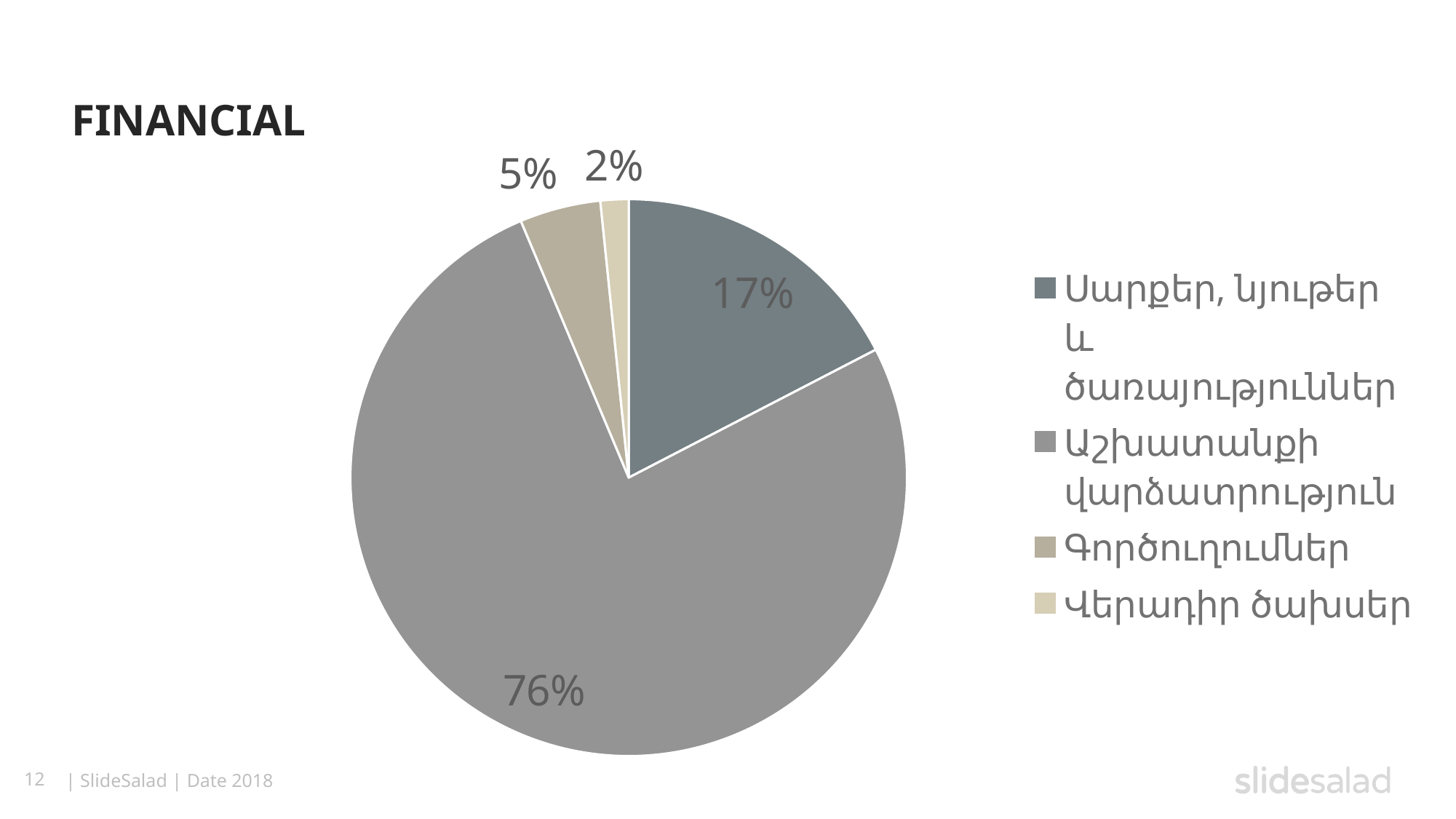
What is the title of the slide containing the pie chart? FINANCIAL Which category has the largest slice of the pie? Աշխատանքի վարձատրություն What share of the pie does Գործուղումներ take? 5% How many entries does the legend of the pie chart list? 4 What is the difference in percentage points between the Աշխատանքի վարձատրություն slice and the Սարքեր, նյութեր և ծառայություններ slice? 59 What share of the pie does Աշխատանքի վարձատրություն take? 76% What share of the pie does Վերադիր ծախսեր take? 2% Which slice is larger: Գործուղումներ or Վերադիր ծախսեր? Գործուղումներ Which category has the smallest slice of the pie? Վերադիր ծախսեր How many slices does the pie chart have? 4 What kind of chart is shown on the slide? pie chart